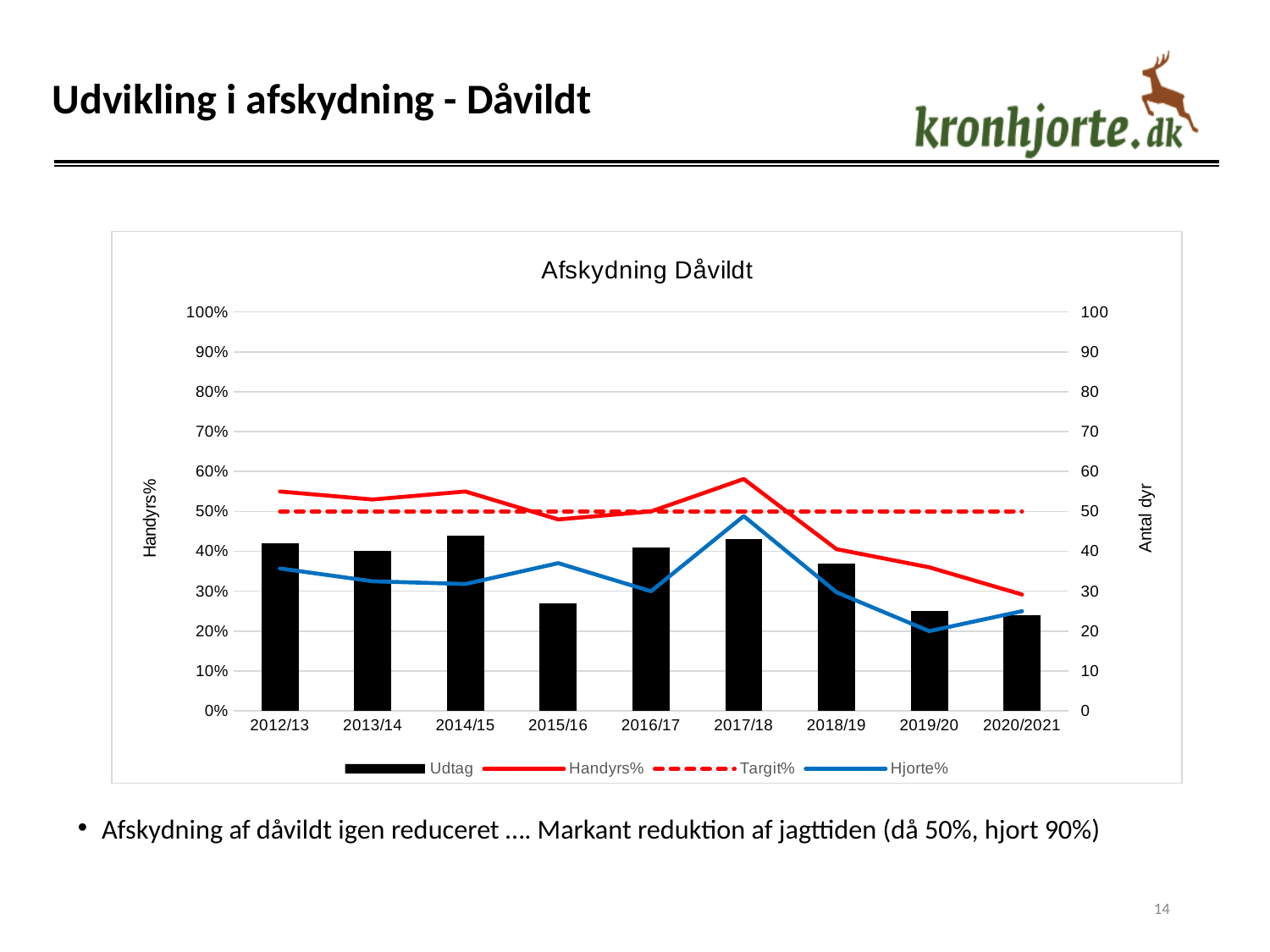
What kind of chart is shown on the slide? A combined bar and line chart Which is larger, the Udtag bar for 2014/15 or the Udtag bar for 2015/16? 2014/15 What is the title of the chart on the slide? Afskydning Dåvildt How many seasons (categories) are shown on the x axis of the chart? 9 Is the Udtag bar for 2015/16 greater or less than 30 on the right axis? less How many series does the chart legend list? 4 In which season does the Hjorte% line reach its lowest value? 2019/20 Is the Udtag bar for 2014/15 greater or less than 40 on the right axis? greater Does the Handyrs% line rise or fall from 2017/18 to 2020/2021? It falls In which season does the Handyrs% line reach its lowest value? 2020/2021 What is the label of the right-hand vertical axis of the chart? Antal dyr In which season does the Handyrs% line reach its highest value? 2017/18